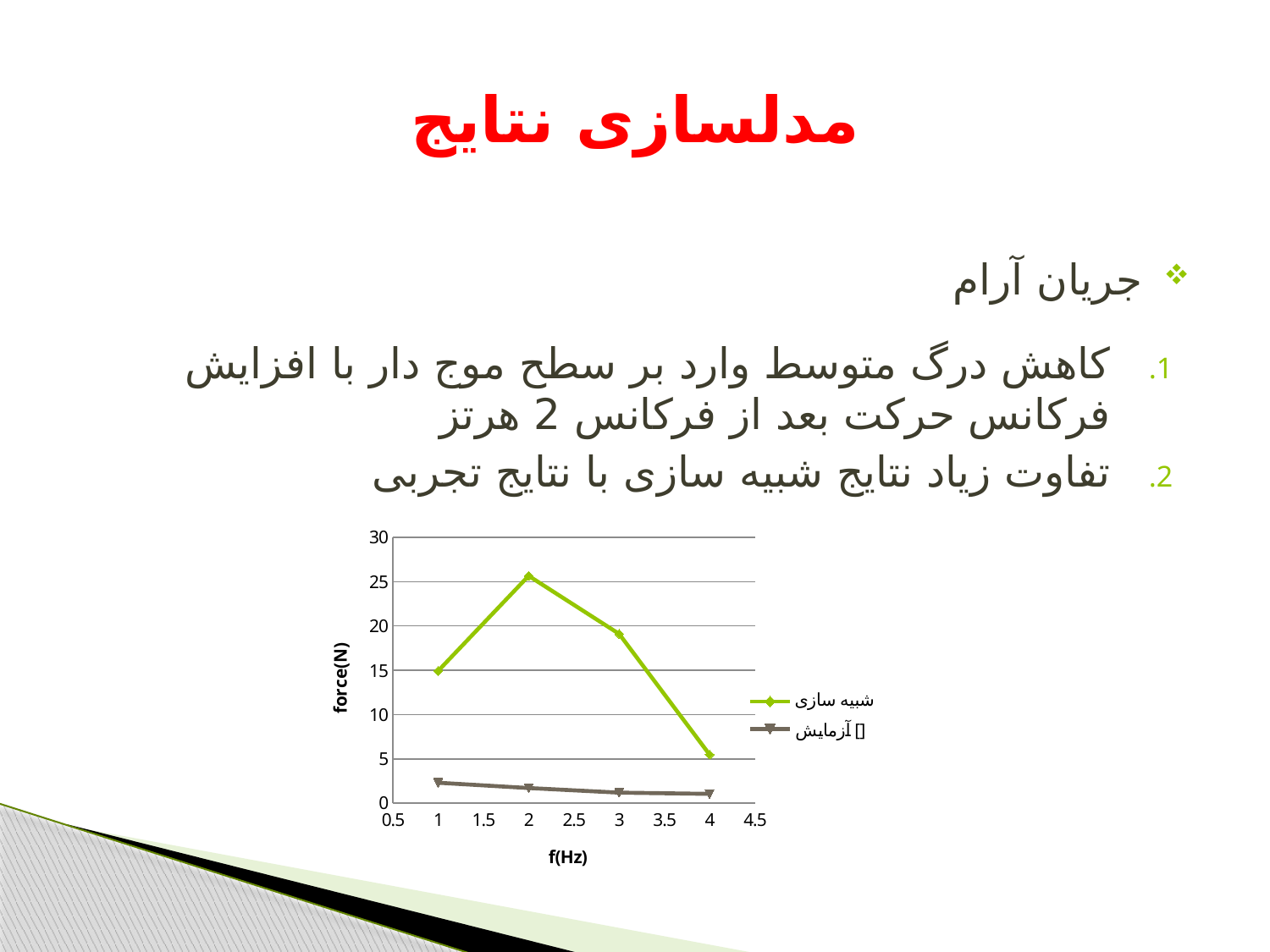
What is the label of the y axis of the chart? force(N) What is the label of the x axis of the chart? f(Hz) What kind of chart is shown on the slide? line chart How many data points are plotted for the شبیه سازی series? 4 Which series has the larger force at f = 3 Hz, شبیه سازی or آزمایش? شبیه سازی At which frequency f(Hz) does the شبیه سازی series have its lowest force? 4 At which frequency f(Hz) does the شبیه سازی series reach its highest force? 2 Is the force for the آزمایش series at f = 1 Hz greater or less than 5? less Does the force for the آزمایش series rise or fall as f(Hz) increases from 1 to 4? fall Is the force for the شبیه سازی series at f = 4 Hz greater or less than 10? less Is the force for the شبیه سازی series at f = 2 Hz greater or less than 25? greater How many series does the chart legend list? 2